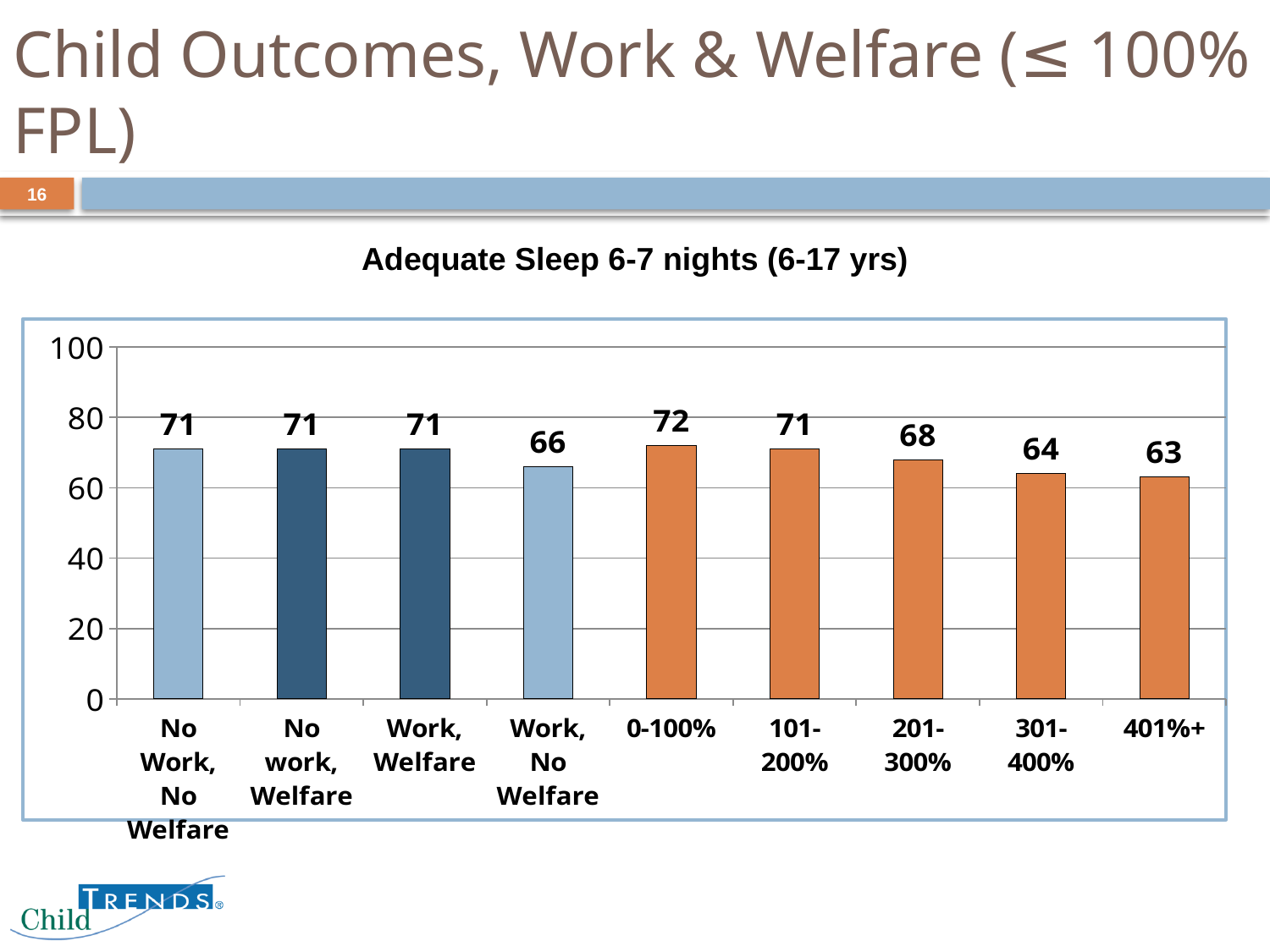
What is the value for the '201-300%' category? 68 Which is larger, the value for '301-400%' or the value for '201-300%'? 201-300% What kind of chart is shown on the slide? Bar chart What is the title of the chart? Adequate Sleep 6-7 nights (6-17 yrs) What is the value for the '0-100%' category? 72 What is the difference between the values for '0-100%' and '401%+'? 9 What is the difference between the values for 'Work, Welfare' and 'Work, No Welfare'? 5 Which category has the lowest value? 401%+ Which category has the highest value? 0-100% What is the value for the '401%+' category? 63 What is the value for the 'Work, No Welfare' category? 66 How many categories are shown on the x axis? 9